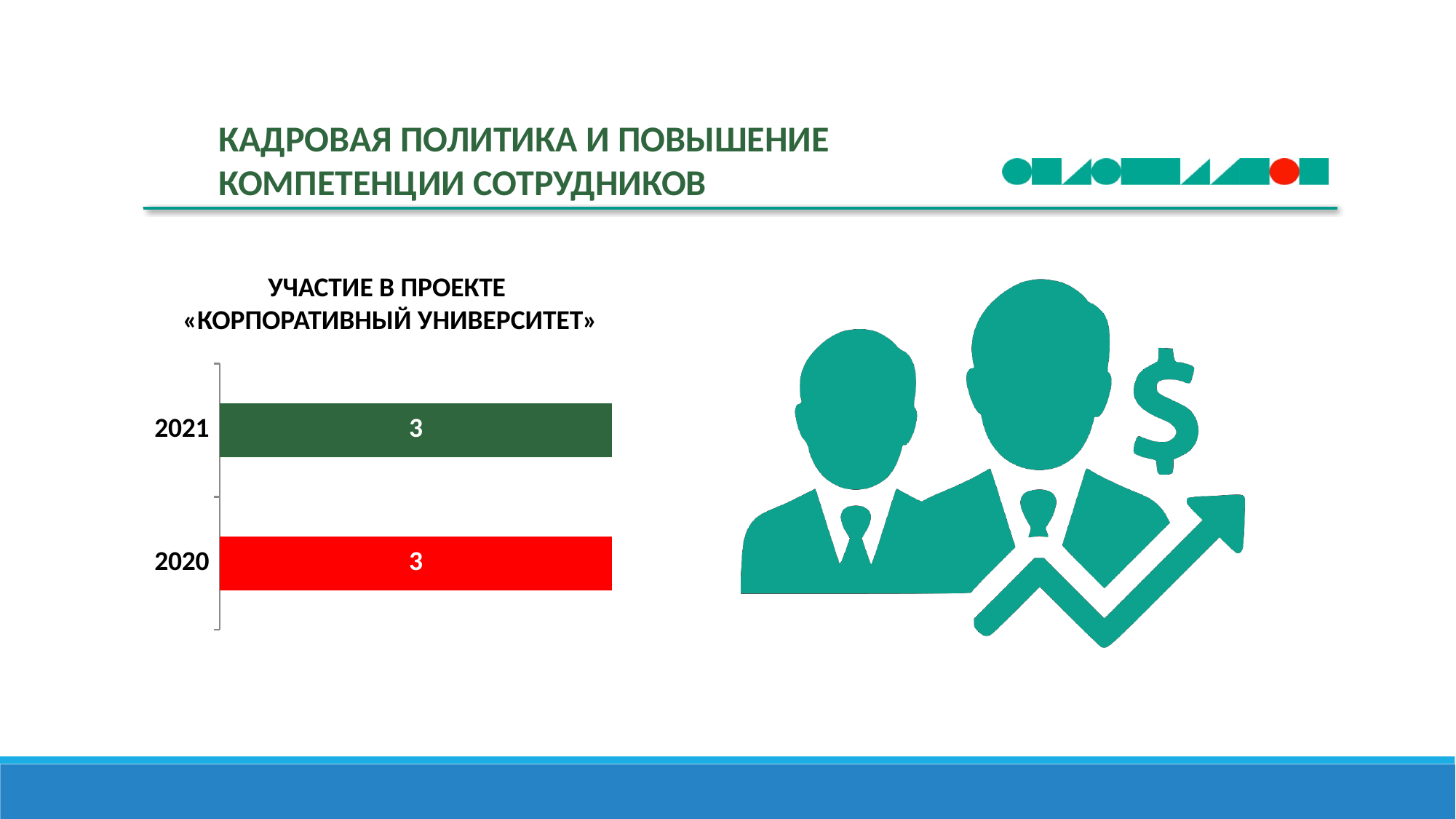
What is the difference between the values for 2021 and 2020 in the chart? 0 Is the value for 2021 greater than, less than, or equal to the value for 2020? equal What is the value for 2021 in the chart «Участие в проекте «Корпоративный университет»»? 3 Which years are shown as categories in the chart? 2021 and 2020 How many categories (years) are shown in the chart? 2 What is the title of the chart on the slide? Участие в проекте «Корпоративный университет» What is the value for 2020 in the chart «Участие в проекте «Корпоративный университет»»? 3 What colour is the bar for 2020 in the chart? red What kind of chart is shown on the slide? bar chart What is the total of the values for 2020 and 2021 in the chart? 6